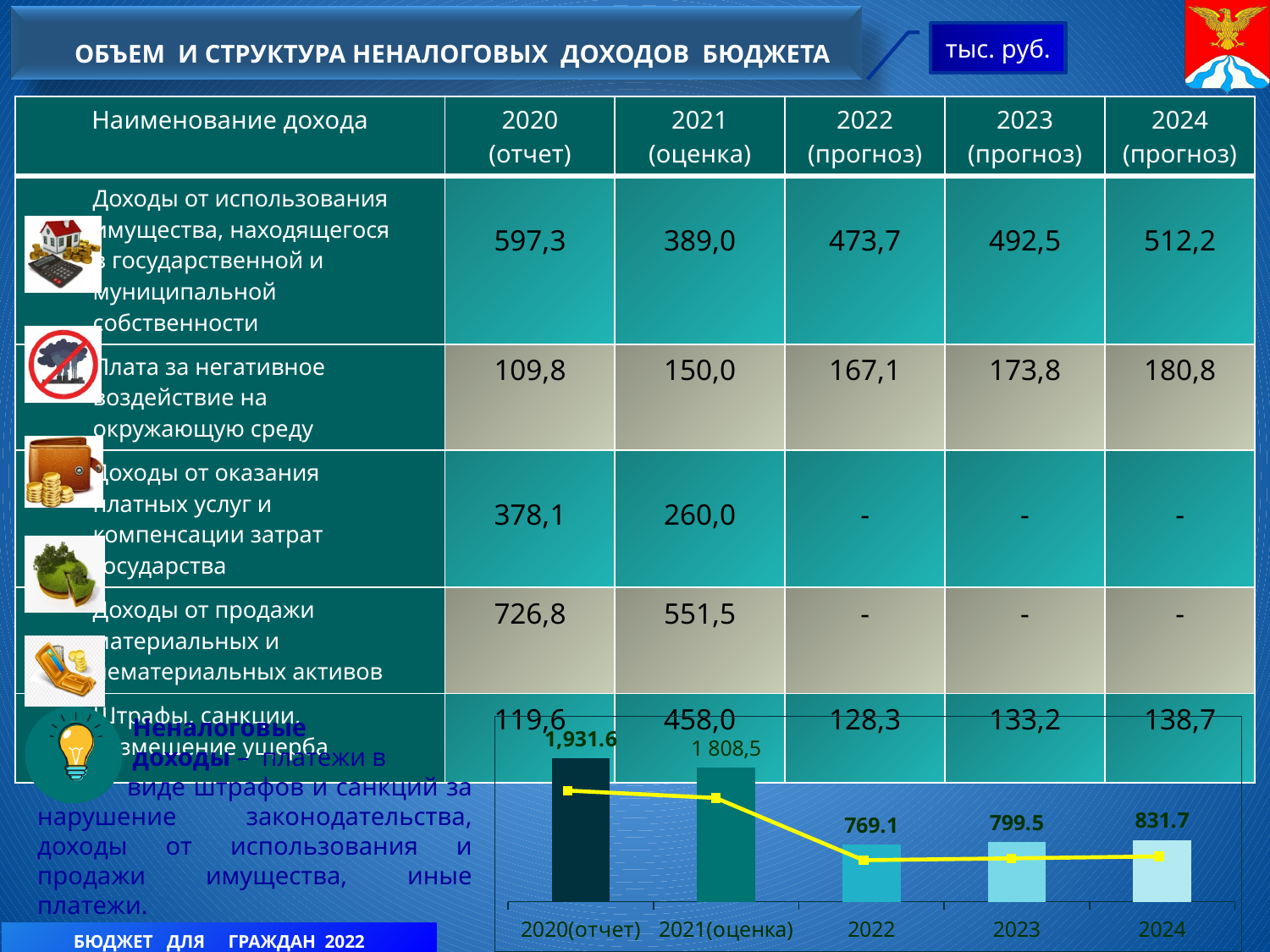
In the bar chart at the bottom of the slide, what is the value for 2020(отчет)? 1,931.6 In the bar chart at the bottom of the slide, what is the difference between the values for 2024 and 2022? 62.6 In the bar chart at the bottom of the slide, how many years (categories) are plotted? 5 In the bar chart at the bottom of the slide, what is the value for 2024? 831.7 In the bar chart at the bottom of the slide, what is the value for 2023? 799.5 In the bar chart at the bottom of the slide, which year has the lowest value? 2022 In the bar chart at the bottom of the slide, which year has the highest value? 2020(отчет) In the bar chart at the bottom of the slide, which is larger: the value for 2023 or the value for 2024? 2024 In the bar chart at the bottom of the slide, what is the value for 2022? 769.1 In the bar chart at the bottom of the slide, do the values rise or fall from 2020(отчет) to 2022? Fall What kind of chart is shown at the bottom of the slide? Bar chart with a line overlay In the bar chart at the bottom of the slide, what is the value for 2021(оценка)? 1 808,5